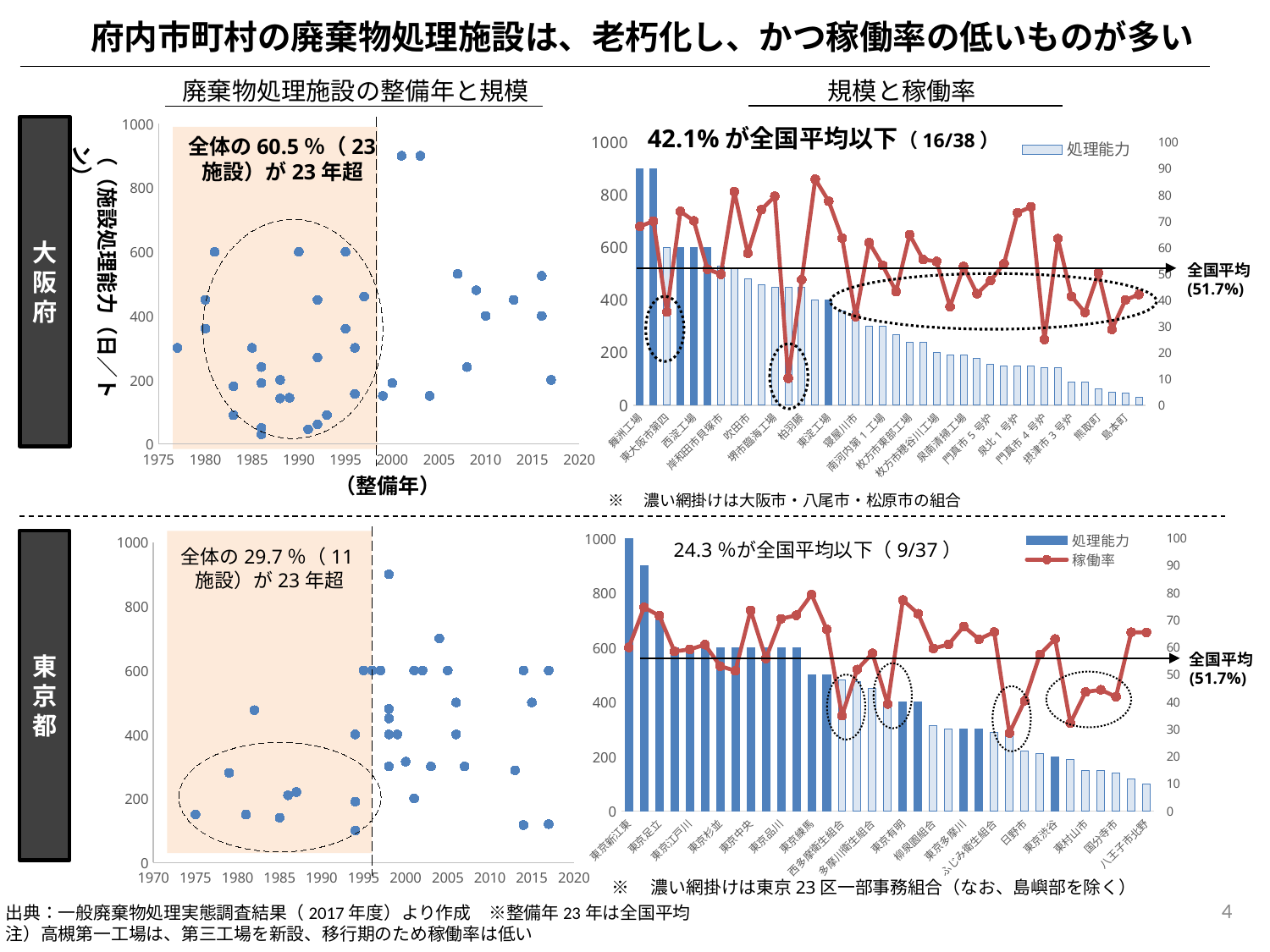
On the bottom-right chart (東京都, 規模と稼働率), how many series does the legend list? 2 On the top-left chart (大阪府, 廃棄物処理施設の整備年と規模), what kind of chart is it? scatter chart On the bottom-left chart (東京都), how many facilities are stated to be over 23 years old? 11 On the bottom-right chart (東京都), what kind of chart is used to show 処理能力? bar chart On the top-right chart (大阪府, 規模と稼働率), how many facilities are stated to be below the national average? 16 On the bottom-right chart (東京都), is the 処理能力 value for 東京新江東 greater or less than 900? greater On the bottom-right chart (東京都), is the 処理能力 value for 八王子市北野 greater or less than 200? less On the bottom-right chart (東京都), what percentage of facilities are stated to be below the national average? 24.3% On the top-right chart (大阪府), is the 処理能力 value for 舞洲工場 greater or less than 800? greater On the top-right chart (大阪府, 規模と稼働率), what is the national average (全国平均) operating rate shown? 51.7% On the bottom-right chart (東京都), which has the larger 処理能力, 東京新江東 or 東京足立? 東京新江東 On the top-left chart (大阪府), what percentage of facilities are stated to be over 23 years old? 60.5%